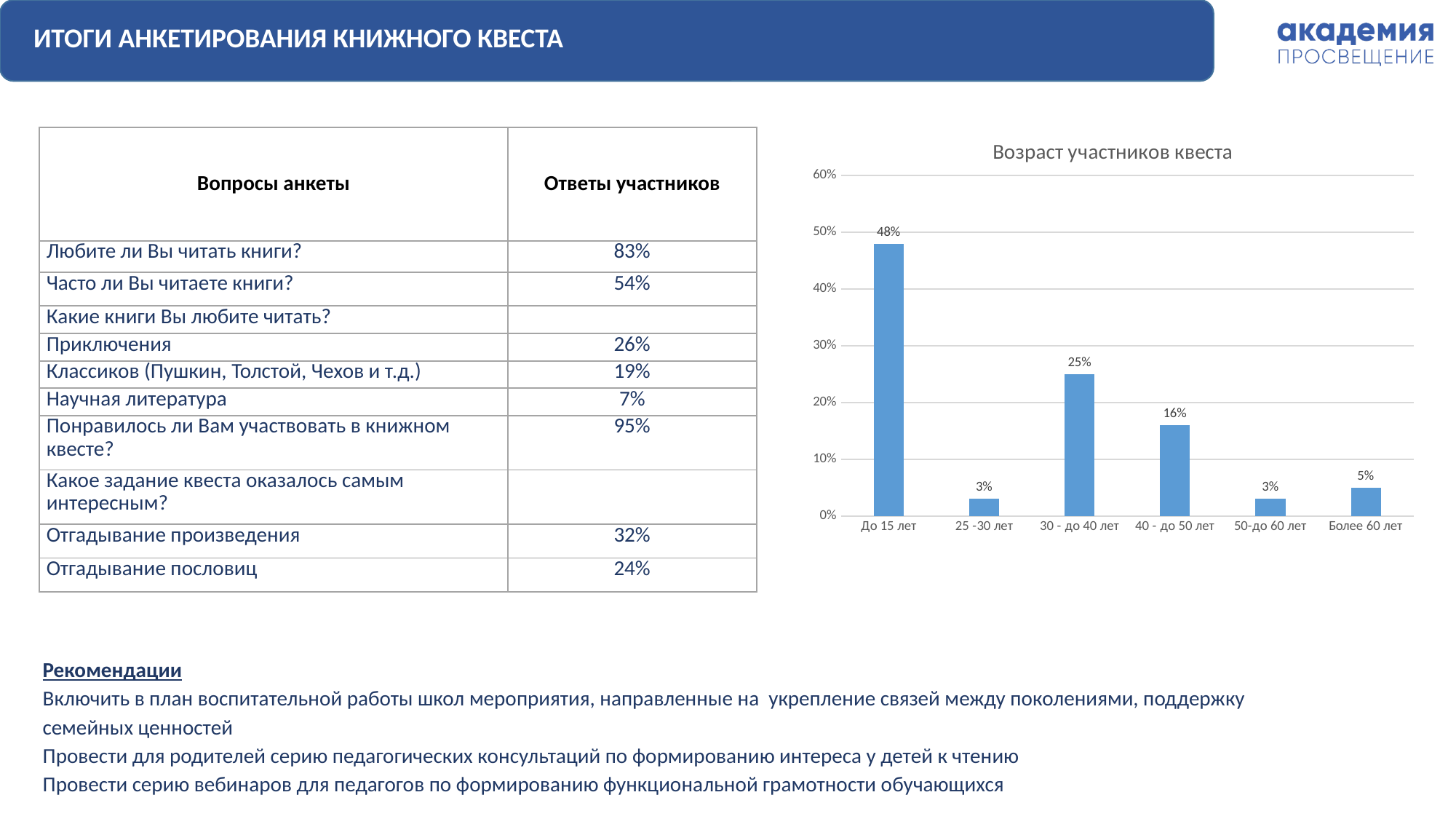
What kind of chart is shown on the slide? bar chart Is the value for 'До 15 лет' greater or less than 40%? greater Which is larger: the value for '30 - до 40 лет' or the value for '40 - до 50 лет'? 30 - до 40 лет What is the value for the 'До 15 лет' category in the chart? 48% What is the value for the 'Более 60 лет' category? 5% What is the difference between the values for '40 - до 50 лет' and 'Более 60 лет'? 11% What is the difference between the values for 'До 15 лет' and '30 - до 40 лет'? 23% What is the value for the '30 - до 40 лет' category? 25% How many age categories are shown in the chart? 6 What is the title of the chart? Возраст участников квеста Which age category has the highest value in the chart? До 15 лет What is the value for the '40 - до 50 лет' category? 16%